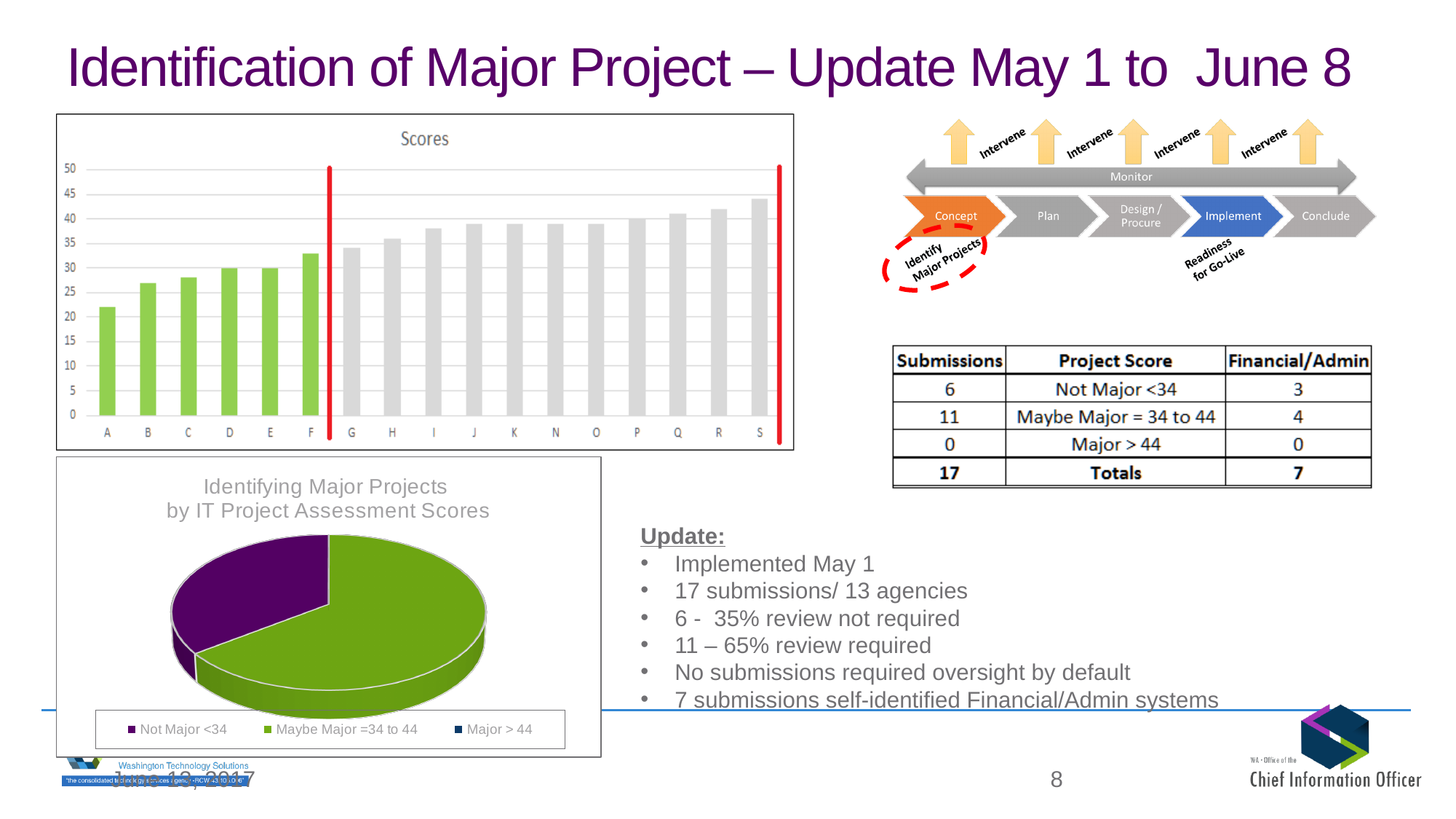
What kind of chart is "Identifying Major Projects by IT Project Assessment Scores"? pie chart How many entries does the legend of the "Identifying Major Projects by IT Project Assessment Scores" chart list? 3 In the "Identifying Major Projects by IT Project Assessment Scores" pie chart, which category has the largest slice? Maybe Major =34 to 44 In the "Scores" chart, do the values rise or fall from A to S along the x axis? rise In the "Identifying Major Projects by IT Project Assessment Scores" pie chart, what colour is the "Not Major <34" slice? purple In the "Scores" chart, is the value for S greater or less than 40? greater In the "Scores" chart, which category has the highest score? S In the "Scores" chart, which has the larger value, B or R? R In the "Scores" chart, how many categories (bars) are plotted? 17 In the "Scores" chart, which category has the lowest score? A In the "Scores" chart, is the value for A greater or less than 25? less What kind of chart is the "Scores" chart? bar chart